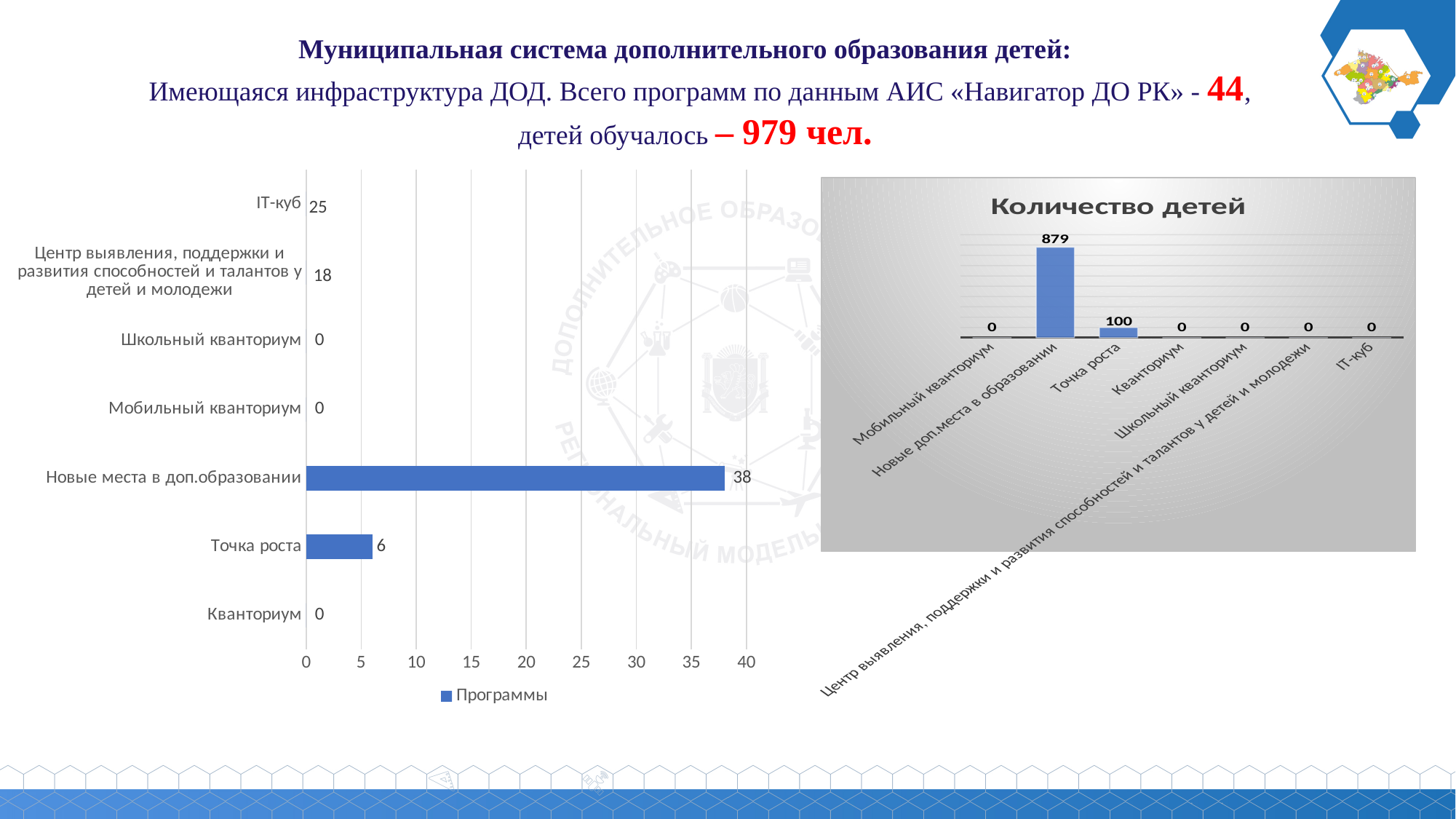
In the left chart (Программы), which category has the highest value? Новые места в доп.образовании What kind of chart is the chart titled Количество детей? Bar chart In the left chart (Программы), how many categories are shown? 7 In the left chart (Программы), what is the value for Точка роста? 6 In the left chart (Программы), how many series does the legend list? 1 In the left chart (Программы), what is the difference between Новые места в доп.образовании and Точка роста? 32 In the chart titled Количество детей, which is larger: Точка роста or Кванториум? Точка роста In the chart titled Количество детей, what is the value for Точка роста? 100 In the chart titled Количество детей, what is the difference between Новые доп.места в образовании and Точка роста? 779 In the left chart (Программы), what is the value for Новые места в доп.образовании? 38 In the chart titled Количество детей, what is the value for Новые доп.места в образовании? 879